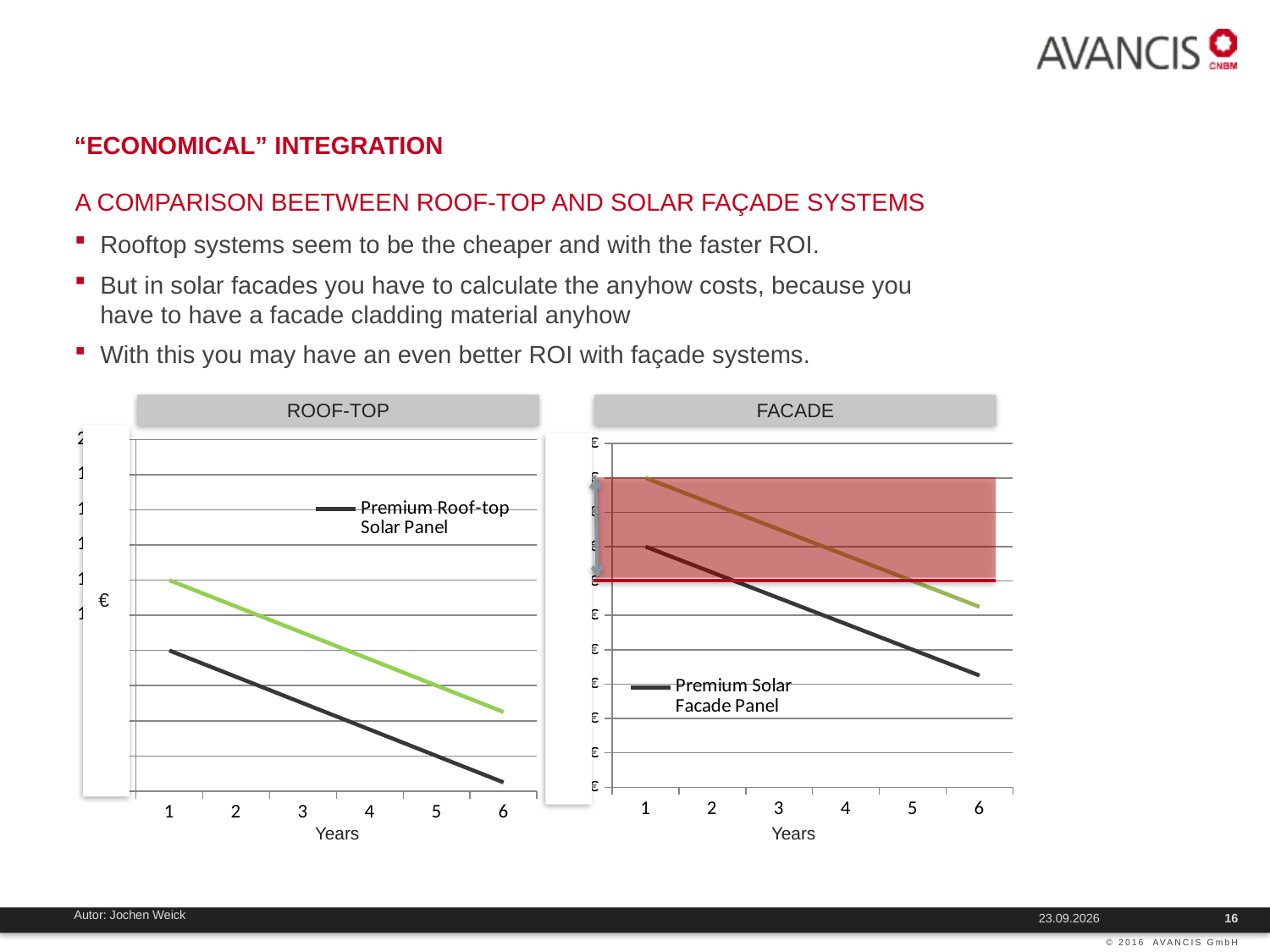
What kind of chart is the FACADE chart? line chart What is the x-axis label of the FACADE chart? Years In the FACADE chart, do the plotted values rise or fall as the years increase? fall How many year points are shown on the x axis of the ROOF-TOP chart? 6 How many year points are shown on the x axis of the FACADE chart? 6 What is the title of the chart on the right side of the slide? FACADE In the ROOF-TOP chart, which line is higher at year 6, the green line or the black line? the green line In the FACADE chart, which line is higher at year 1, the brown line or the black line? the brown line What kind of chart is the ROOF-TOP chart? line chart What legend entry is shown in the ROOF-TOP chart? Premium Roof-top Solar Panel In the ROOF-TOP chart, do the plotted values rise or fall as the years increase? fall